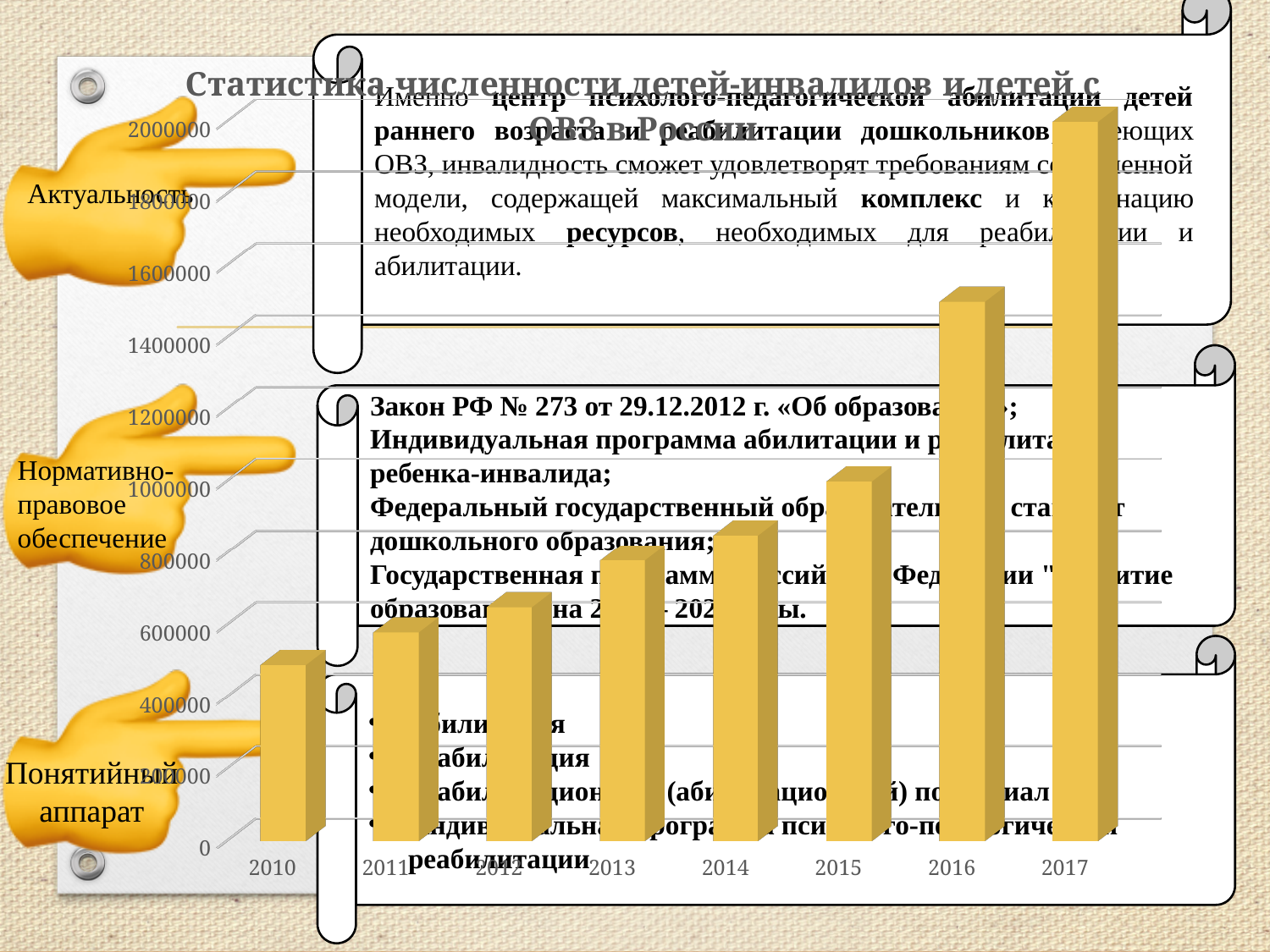
Is the value for 2012 greater or less than 800000? less How many years are shown on the x axis of the chart? 8 Which is larger, the value for 2016 or the value for 2015? 2016 Is the value for 2016 greater or less than 1400000? greater What kind of chart is shown on the slide? bar chart Do the values in the chart rise or fall from 2010 to 2017? rise Is the value for 2014 greater or less than 800000? greater Which year has the lowest bar in the chart? 2010 Which year has the highest bar in the chart? 2017 What is the first year shown on the x axis of the chart? 2010